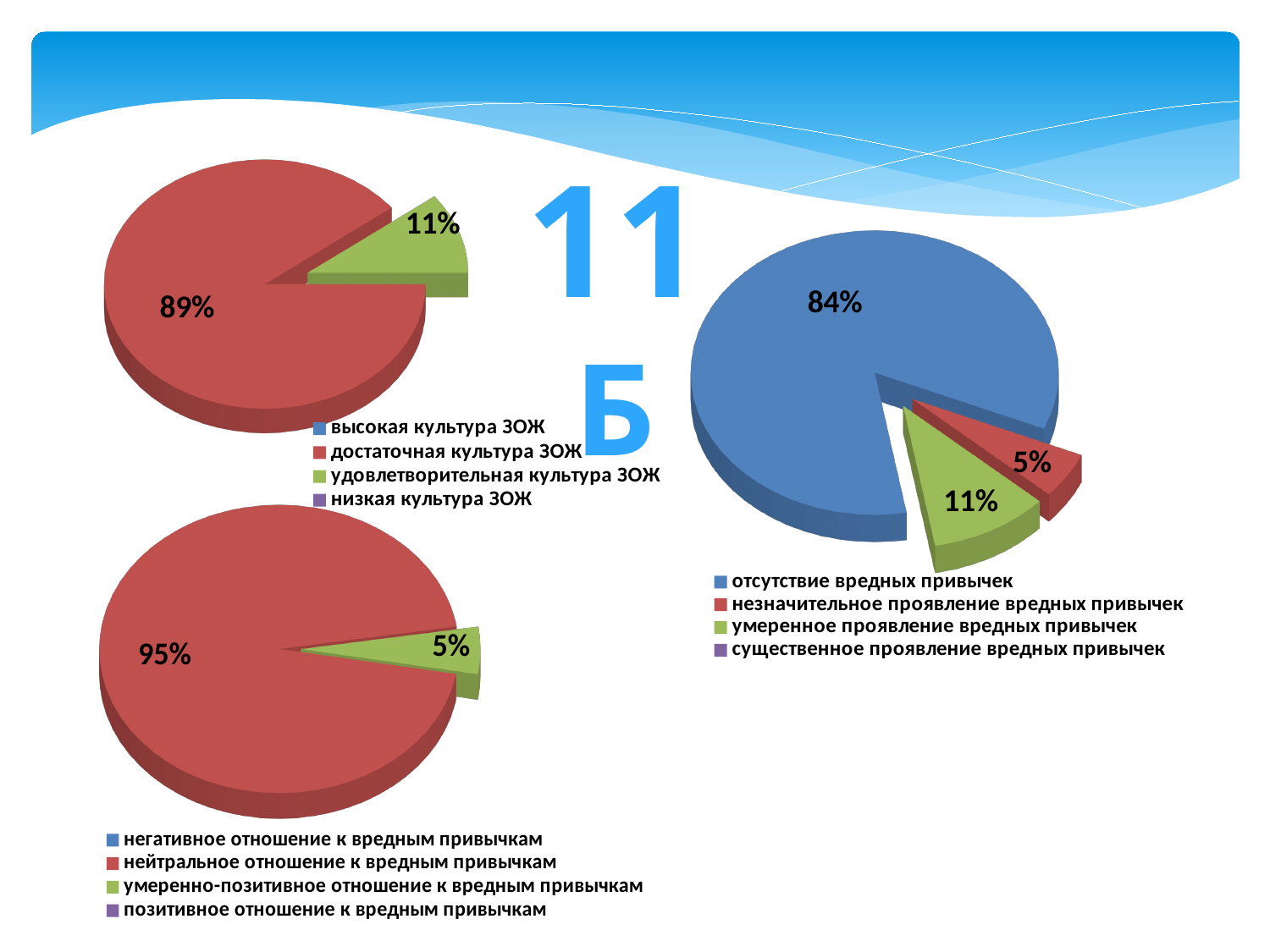
In the bottom-left pie chart, what share is shown for 'нейтральное отношение к вредным привычкам'? 95% In the right-hand pie chart, what is the difference between the shares for 'отсутствие вредных привычек' and 'умеренное проявление вредных привычек'? 73% In the right-hand pie chart, which labelled category has the smallest slice? незначительное проявление вредных привычек In the right-hand pie chart, what share is shown for 'незначительное проявление вредных привычек'? 5% What type of chart is the right-hand chart? pie chart In the top-left pie chart, what share is shown for 'достаточная культура ЗОЖ'? 89% How many entries does the legend of the bottom-left pie chart list? 4 In the right-hand pie chart, what share is shown for 'отсутствие вредных привычек'? 84% In the right-hand pie chart, what share is shown for 'умеренное проявление вредных привычек'? 11% In the bottom-left pie chart, what share is shown for 'умеренно-позитивное отношение к вредным привычкам'? 5% In the top-left pie chart, which category has the largest slice? достаточная культура ЗОЖ In the top-left pie chart, what share is shown for 'удовлетворительная культура ЗОЖ'? 11%